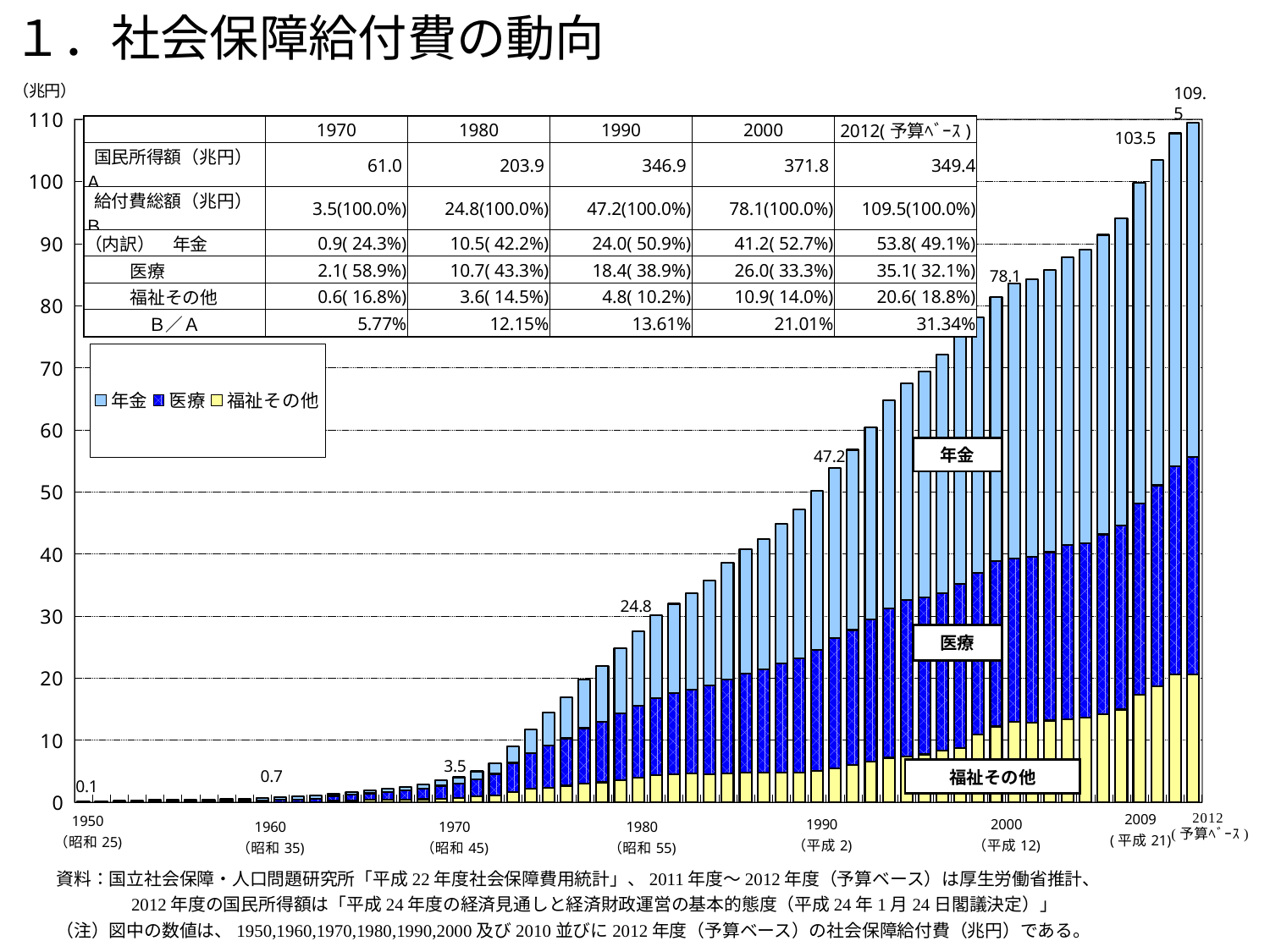
What are the three series listed in the chart legend? 年金, 医療, 福祉その他 What is the labelled total social security benefit value for 1980? 24.8 Do the total bar heights rise or fall from 1950 to 2012? rise What is the labelled total value for 2000? 78.1 What is the labelled total value for 2012 (予算ベース)? 109.5 What is the difference between the labelled totals for 2000 and 1990? 30.9 Which year has the highest total bar in the chart? 2012 What is the difference between the labelled totals for 2012 and 2009? 6.0 What is the labelled total value for 1970? 3.5 How many series does the chart legend list? 3 What is the labelled total value for 1990? 47.2 What kind of chart is shown on the slide? bar chart